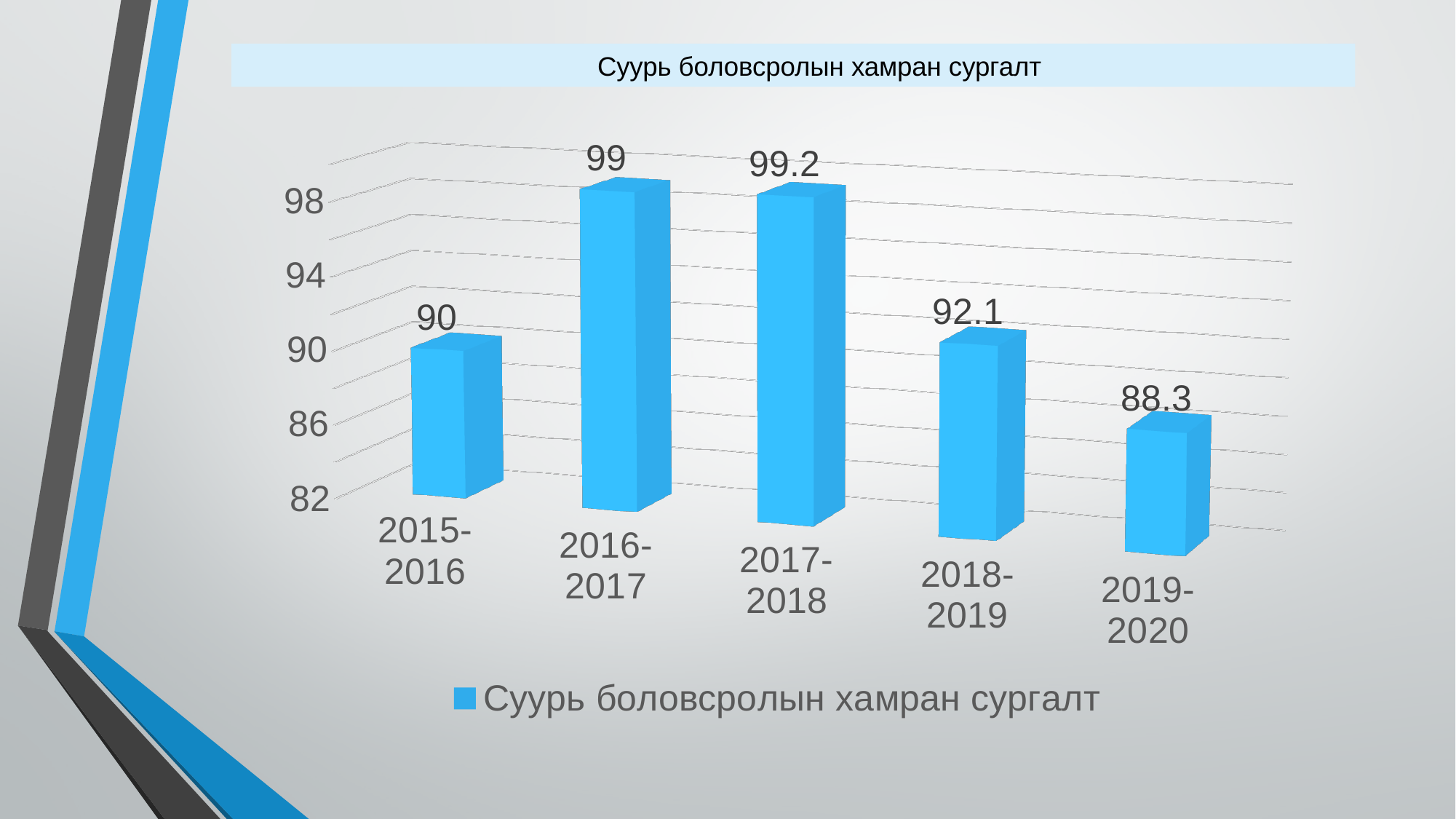
What kind of chart is this? bar chart What is the difference between the values for 2018-2019 and 2019-2020? 3.8 What is the value for 2015-2016? 90 Which is larger, the value for 2016-2017 or the value for 2018-2019? 2016-2017 Which category has the lowest value? 2019-2020 How many categories are shown on the x axis? 5 Which category has the highest value? 2017-2018 What is the value for 2017-2018? 99.2 What is the difference between the values for 2016-2017 and 2015-2016? 9 What is the title of the chart? Суурь боловсролын хамран сургалт What is the value for 2019-2020? 88.3 What is the value for 2018-2019? 92.1